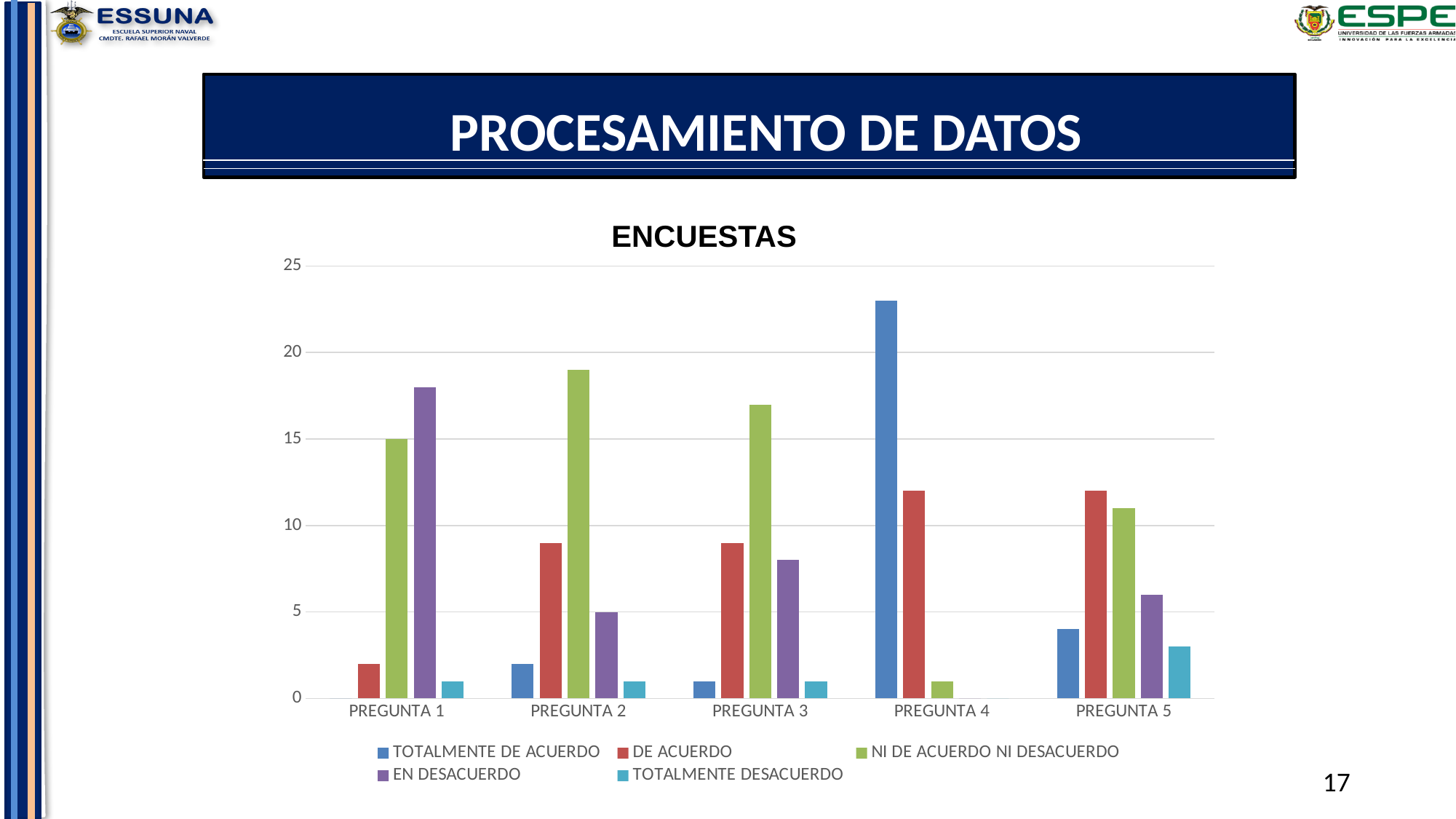
Which is larger: TOTALMENTE DE ACUERDO in PREGUNTA 4 or TOTALMENTE DE ACUERDO in PREGUNTA 5? PREGUNTA 4 Is the value for NI DE ACUERDO NI DESACUERDO in PREGUNTA 2 greater or less than 15? greater What is the title of the chart? ENCUESTAS Which category has the tallest bar in the whole chart? PREGUNTA 4 Is the value for TOTALMENTE DE ACUERDO in PREGUNTA 4 greater or less than 20? greater What is the value for EN DESACUERDO in PREGUNTA 2? 5 What type of chart is shown on the slide? bar chart How many series does the legend list? 5 How many categories (preguntas) are shown on the x axis? 5 What is the value for NI DE ACUERDO NI DESACUERDO in PREGUNTA 1? 15 Is the value for TOTALMENTE DESACUERDO in PREGUNTA 5 greater or less than 5? less In PREGUNTA 1, which series has the highest value? EN DESACUERDO